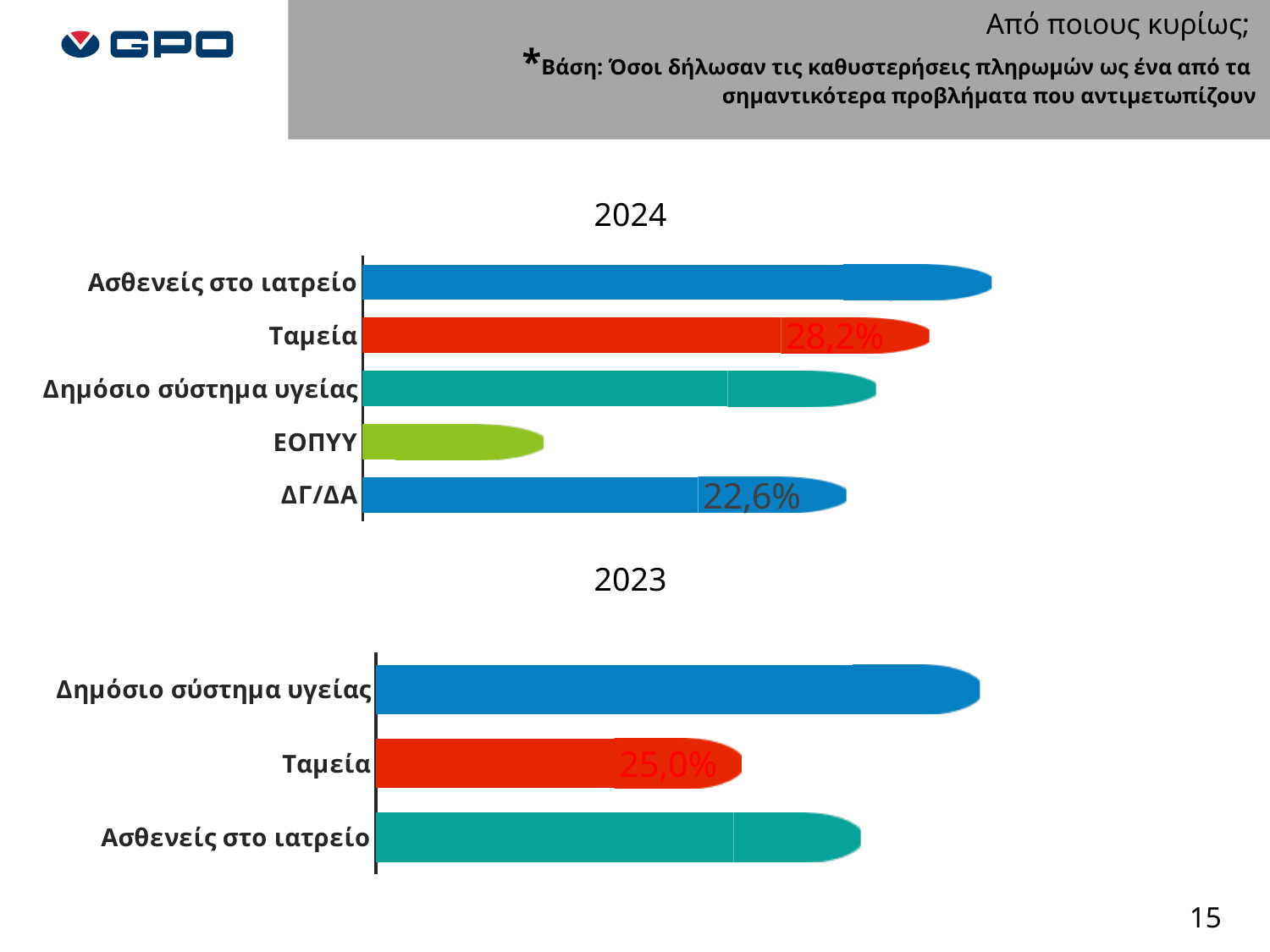
In the 2024 chart, what is the value for ΔΓ/ΔΑ? 22,6% In the 2024 chart, which category has the highest value? Ασθενείς στο ιατρείο In the 2023 chart, what is the value for Ταμεία? 25,0% In the 2023 chart, which category has the highest value? Δημόσιο σύστημα υγείας In the 2024 chart, how many categories are shown? 5 In the 2024 chart, which category has the lowest value? ΕΟΠΥΥ In the 2024 chart, which is larger: Ταμεία or Δημόσιο σύστημα υγείας? Ταμεία In the 2024 chart, what is the difference between the values for Ταμεία and ΔΓ/ΔΑ? 5,6% In the 2024 chart, what is the value for Ταμεία? 28,2% In the 2023 chart, how many categories are shown? 3 What kind of chart is the 2024 chart? Bar chart In the 2023 chart, which category has the lowest value? Ταμεία